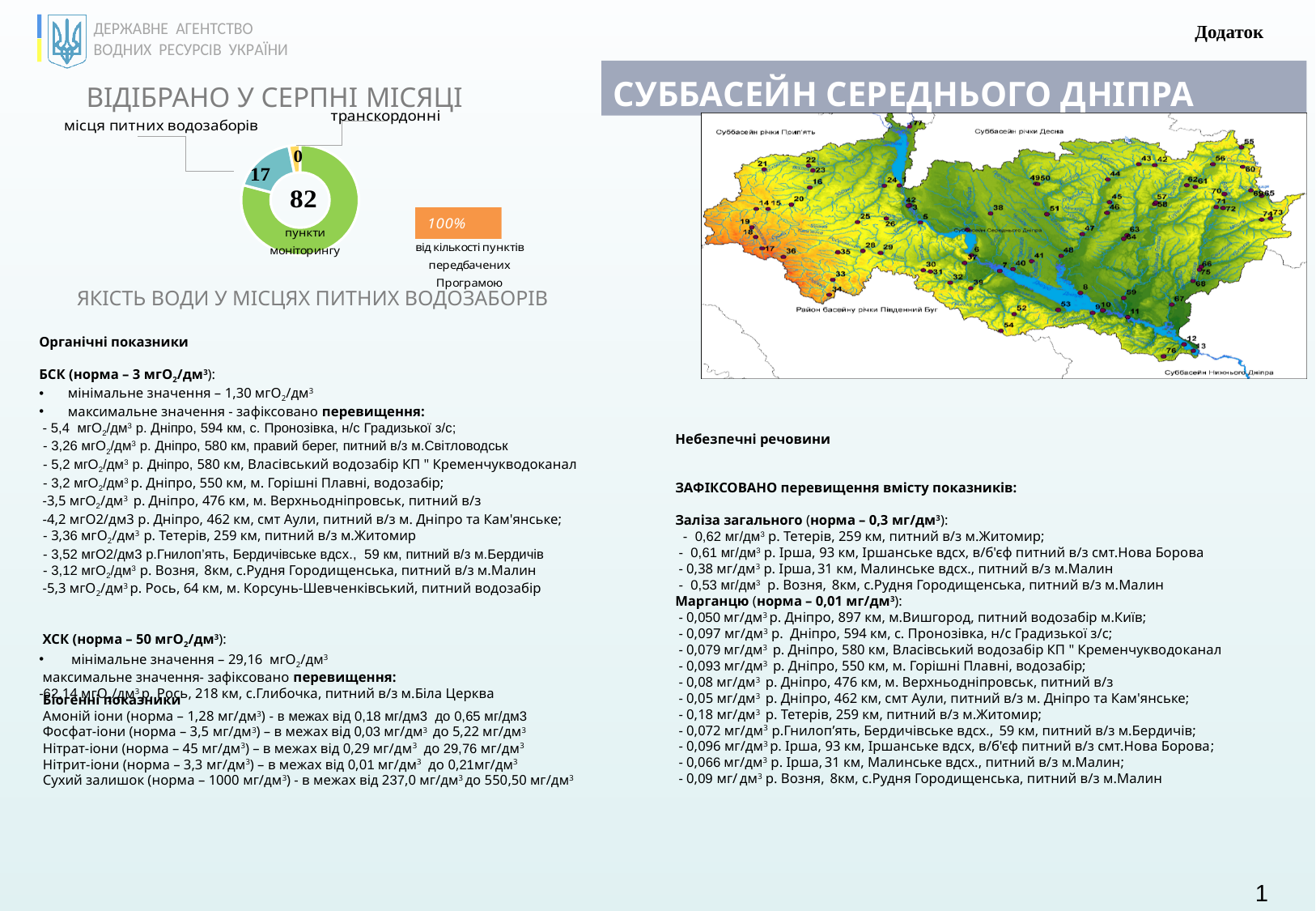
What percentage is shown in the orange box next to the doughnut chart? 100% In the doughnut chart, what is the value for "пункти моніторингу"? 82 In the doughnut chart, which is larger: "місця питних водозаборів" or "транскордонні"? місця питних водозаборів What is the difference between the values for "пункти моніторингу" and "місця питних водозаборів" in the doughnut chart? 65 How many categories are shown in the doughnut chart? 3 Which category in the doughnut chart has the highest value? пункти моніторингу What type of chart is shown under the heading "ВІДІБРАНО У СЕРПНІ МІСЯЦІ"? Doughnut chart Which category in the doughnut chart has the lowest value? транскордонні In the doughnut chart, what is the value for "місця питних водозаборів"? 17 In the doughnut chart, what is the value for "транскордонні"? 0 What colour is the segment for "пункти моніторингу" in the doughnut chart? Green